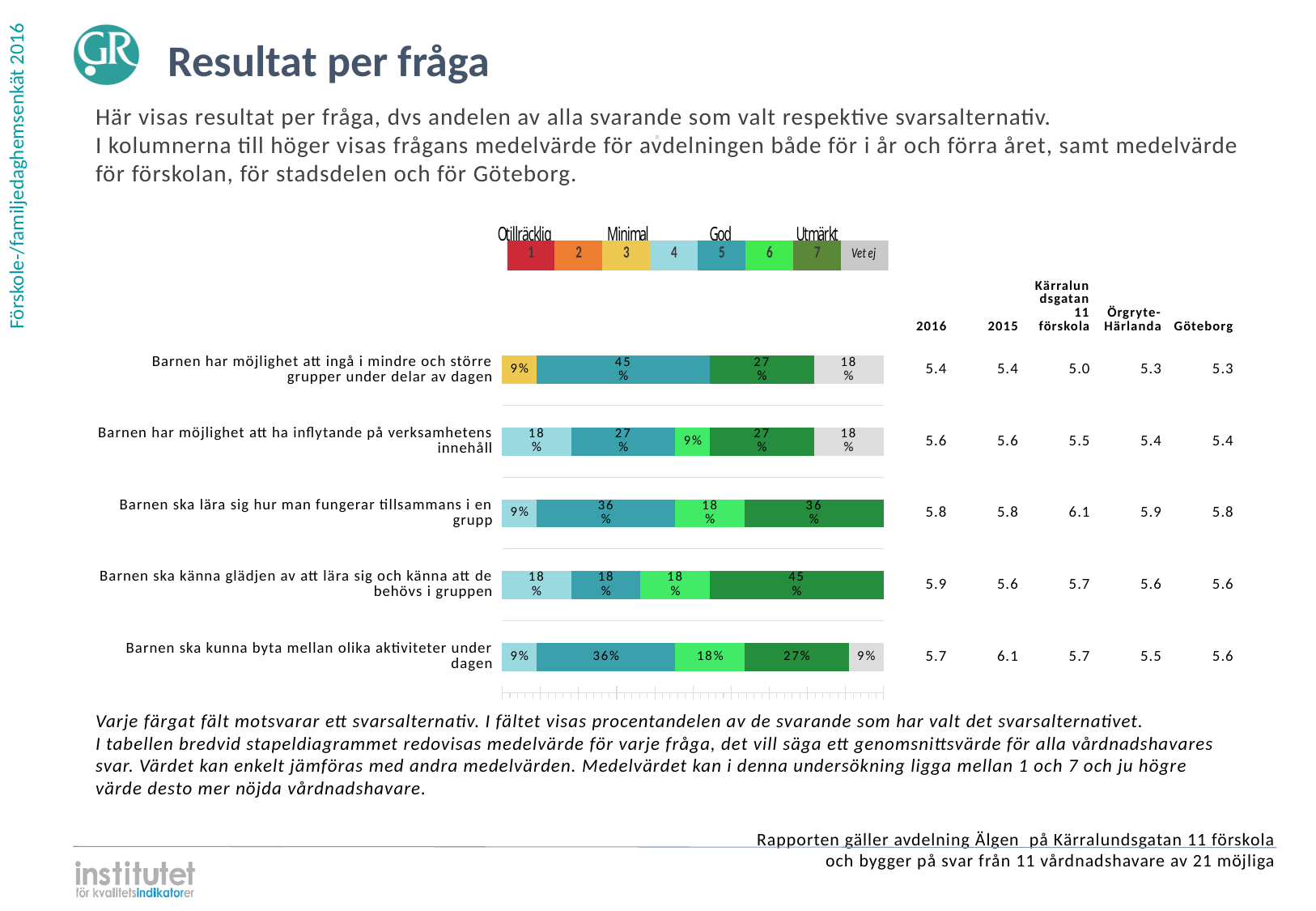
How many questions (bars) are shown in the chart? 5 What percentage chose answer 6 (bright green) for 'Barnen ska kunna byta mellan olika aktiviteter under dagen'? 18% What is the 2015 mean value for 'Barnen ska kunna byta mellan olika aktiviteter under dagen'? 6.1 What percentage chose answer 7 (dark green) for 'Barnen ska känna glädjen av att lära sig och känna att de behövs i gruppen'? 45% What is the difference between the share of answer 5 and the share of answer 7 for 'Barnen ska kunna byta mellan olika aktiviteter under dagen'? 9% What is the 2016 mean value for 'Barnen ska känna glädjen av att lära sig och känna att de behövs i gruppen'? 5.9 Which is larger for 'Barnen har möjlighet att ha inflytande på verksamhetens innehåll': the share of answer 5 or the share of answer 6? Answer 5 (27%) What percentage of respondents chose 'Vet ej' for 'Barnen har möjlighet att ingå i mindre och större grupper under delar av dagen'? 18% What percentage chose answer 5 for 'Barnen har möjlighet att ingå i mindre och större grupper under delar av dagen'? 45% Which question has the largest share of answer 7 (dark green)? Barnen ska känna glädjen av att lära sig och känna att de behövs i gruppen What kind of chart is shown on the slide? Stacked bar chart How many answer categories does the legend above the chart list? 8